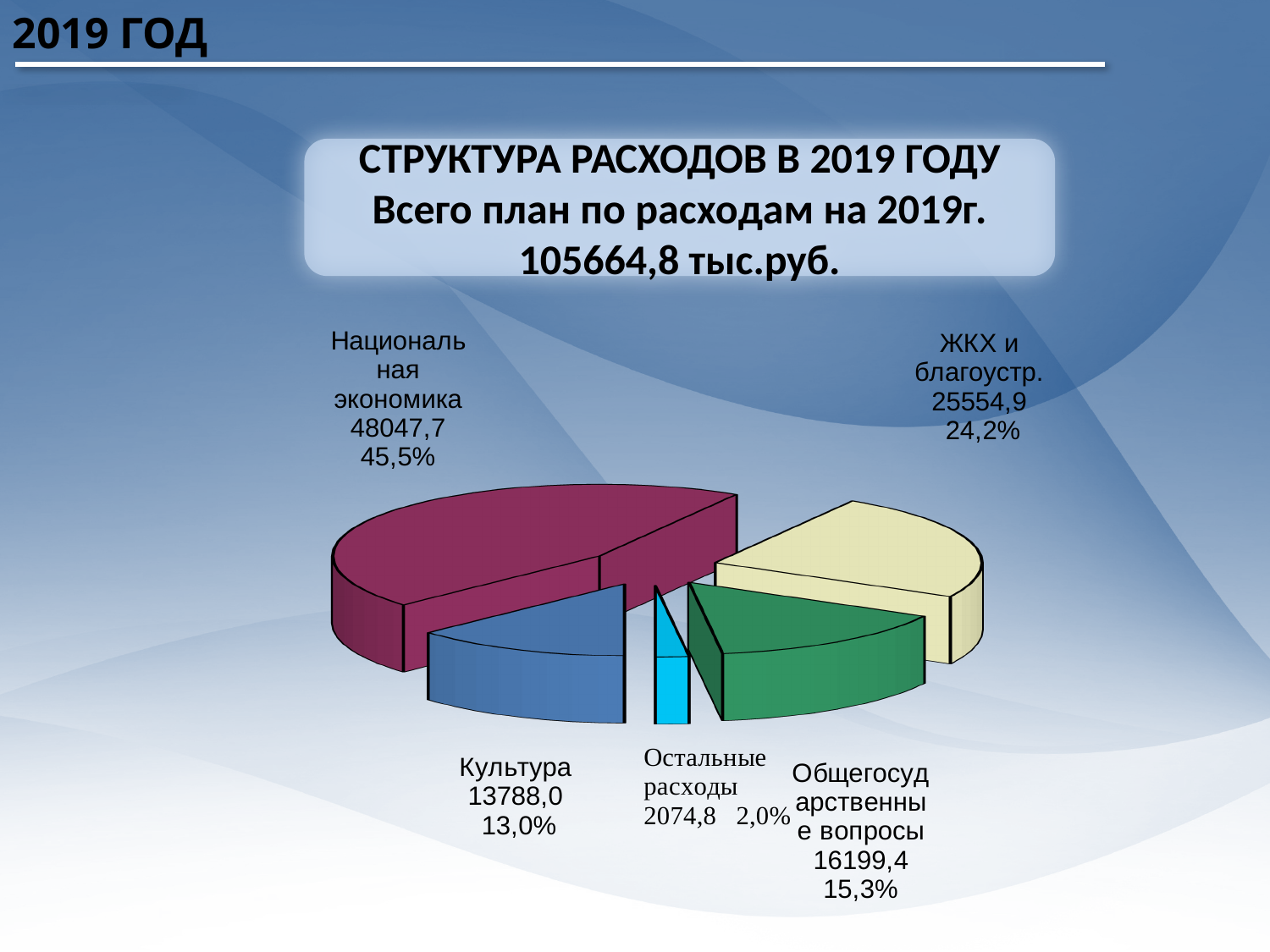
What total planned expenditure for 2019 is stated in the chart title? 105664,8 тыс.руб. What share of the pie does ЖКХ и благоустр. take? 24,2% What is the value shown for Национальная экономика? 48047,7 Which category has the smallest slice of the pie? Остальные расходы What kind of chart is shown on the slide? pie chart How many slices does the pie chart have? 5 What is the value shown for Остальные расходы? 2074,8 What is the difference between the values for Национальная экономика and ЖКХ и благоустр.? 22492,8 What percentage is shown for Культура? 13,0% What is the value shown for Общегосударственные вопросы? 16199,4 Which is larger, the value for Культура or the value for Общегосударственные вопросы? Общегосударственные вопросы Which category has the largest slice of the pie? Национальная экономика